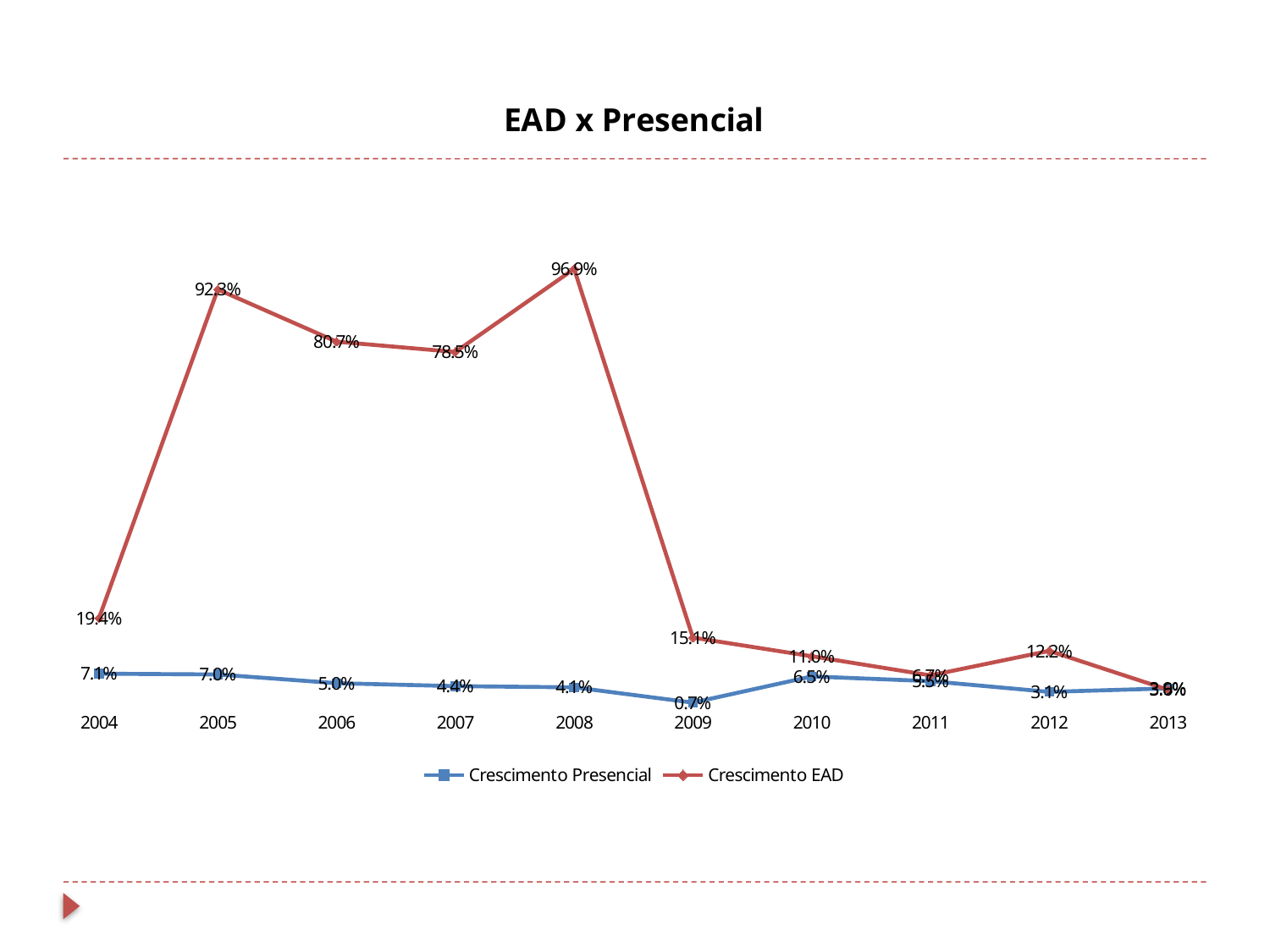
What is the value of Crescimento Presencial in 2009? 0.7% What is the title of the chart? EAD x Presencial What is the value of Crescimento EAD in 2008? 96.9% In which year is Crescimento EAD highest? 2008 In 2004, which series has the larger value, Crescimento EAD or Crescimento Presencial? Crescimento EAD What is the value of Crescimento EAD in 2004? 19.4% How many years are plotted along the x axis? 10 What is the difference between Crescimento EAD in 2005 and in 2006? 11.6 percentage points Does Crescimento EAD rise or fall from 2008 to 2009? Fall How many series does the legend list? 2 In which year is Crescimento Presencial lowest? 2009 What kind of chart is shown on the slide? Line chart